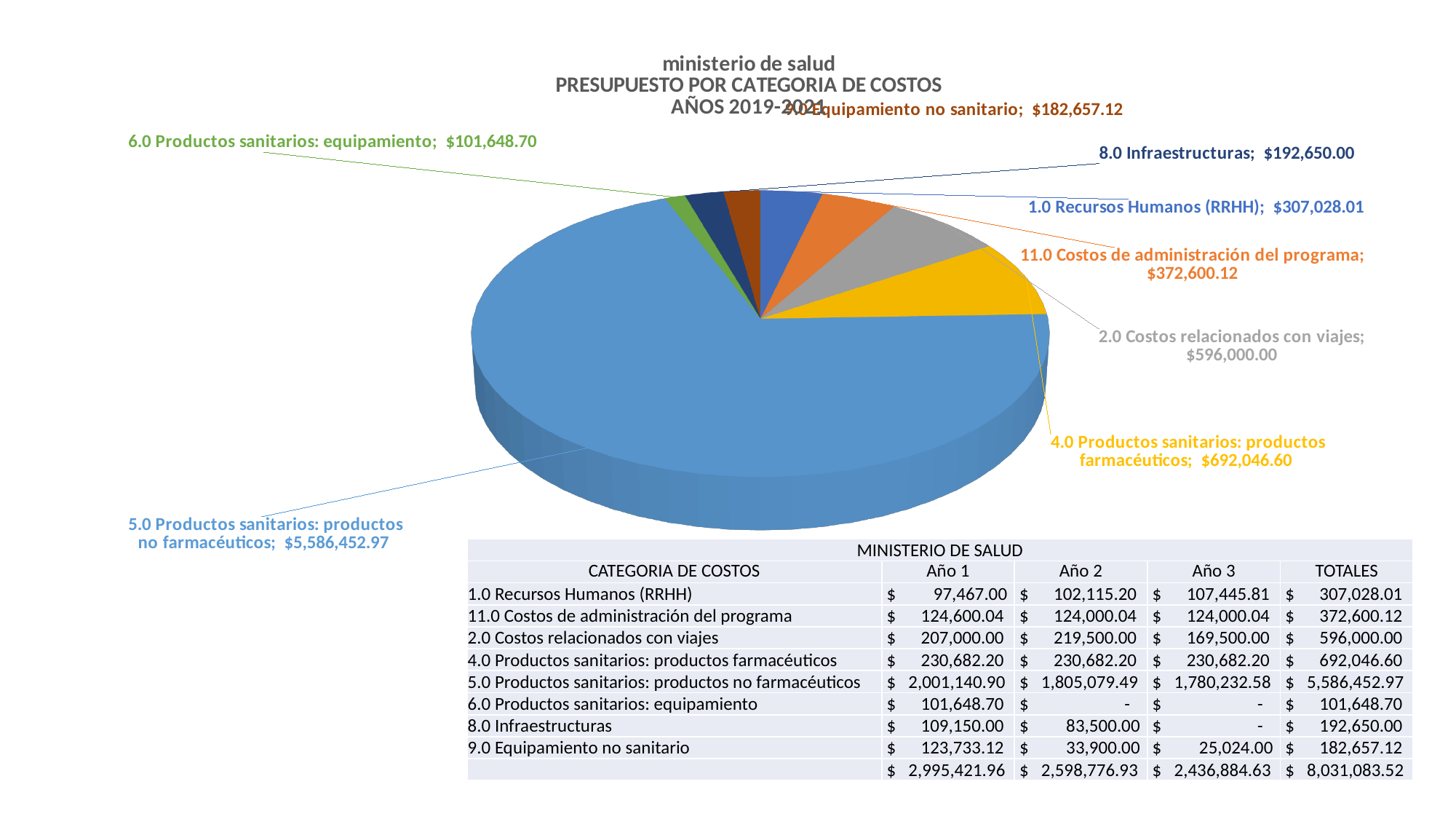
What is the value shown for 8.0 Infraestructuras in the pie chart? $192,650.00 How many slices does the pie chart have? 8 What is the value shown for 2.0 Costos relacionados con viajes in the pie chart? $596,000.00 Which category has the largest slice in the pie chart? 5.0 Productos sanitarios: productos no farmacéuticos What is the difference between the values for 4.0 Productos sanitarios: productos farmacéuticos and 2.0 Costos relacionados con viajes in the pie chart? $96,046.60 Which category has the smallest slice in the pie chart? 6.0 Productos sanitarios: equipamiento In the pie chart, which is larger: 4.0 Productos sanitarios: productos farmacéuticos or 2.0 Costos relacionados con viajes? 4.0 Productos sanitarios: productos farmacéuticos What is the value shown for 11.0 Costos de administración del programa in the pie chart? $372,600.12 What kind of chart is shown on the slide? Pie chart What is the value shown for 5.0 Productos sanitarios: productos no farmacéuticos in the pie chart? $5,586,452.97 What years does the pie chart title say the budget covers? 2019-2021 What is the difference between the values for 11.0 Costos de administración del programa and 1.0 Recursos Humanos (RRHH) in the pie chart? $65,572.11